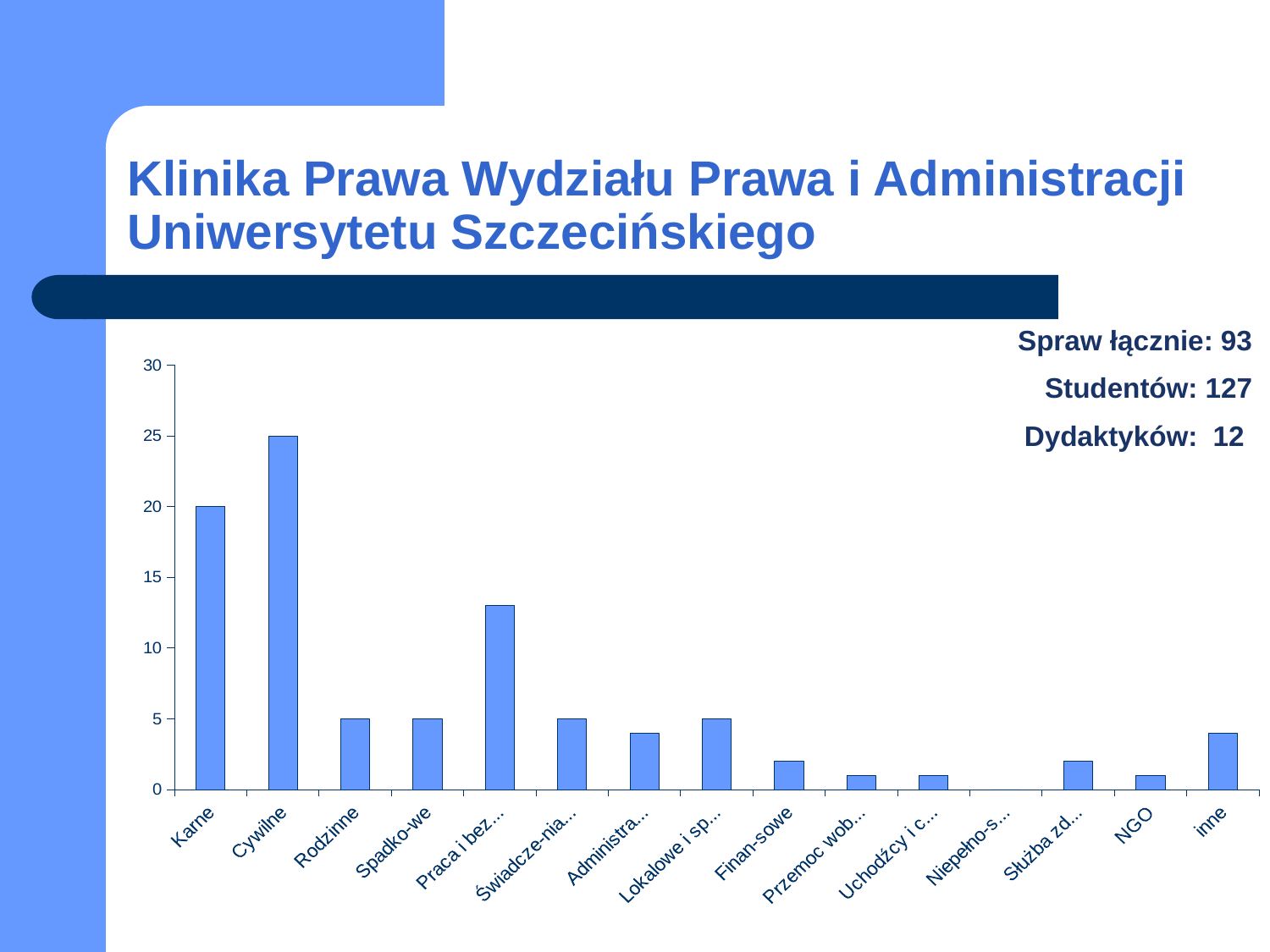
Which category has the lowest value in the chart? Niepełno-s... How many categories are shown on the x axis of the chart? 15 What type of chart is shown on the slide? bar chart Is the value for Praca i bez... greater or less than 10? greater Which category has the highest value in the chart? Cywilne What is the value for Rodzinne? 5 What is the value for Cywilne? 25 What is the value for Karne? 20 Which is larger, the value for Karne or the value for Cywilne? Cywilne What is the difference between the values for Cywilne and Karne? 5 Is the value for Finan-sowe greater or less than 5? less What is the maximum value shown on the vertical axis of the chart? 30